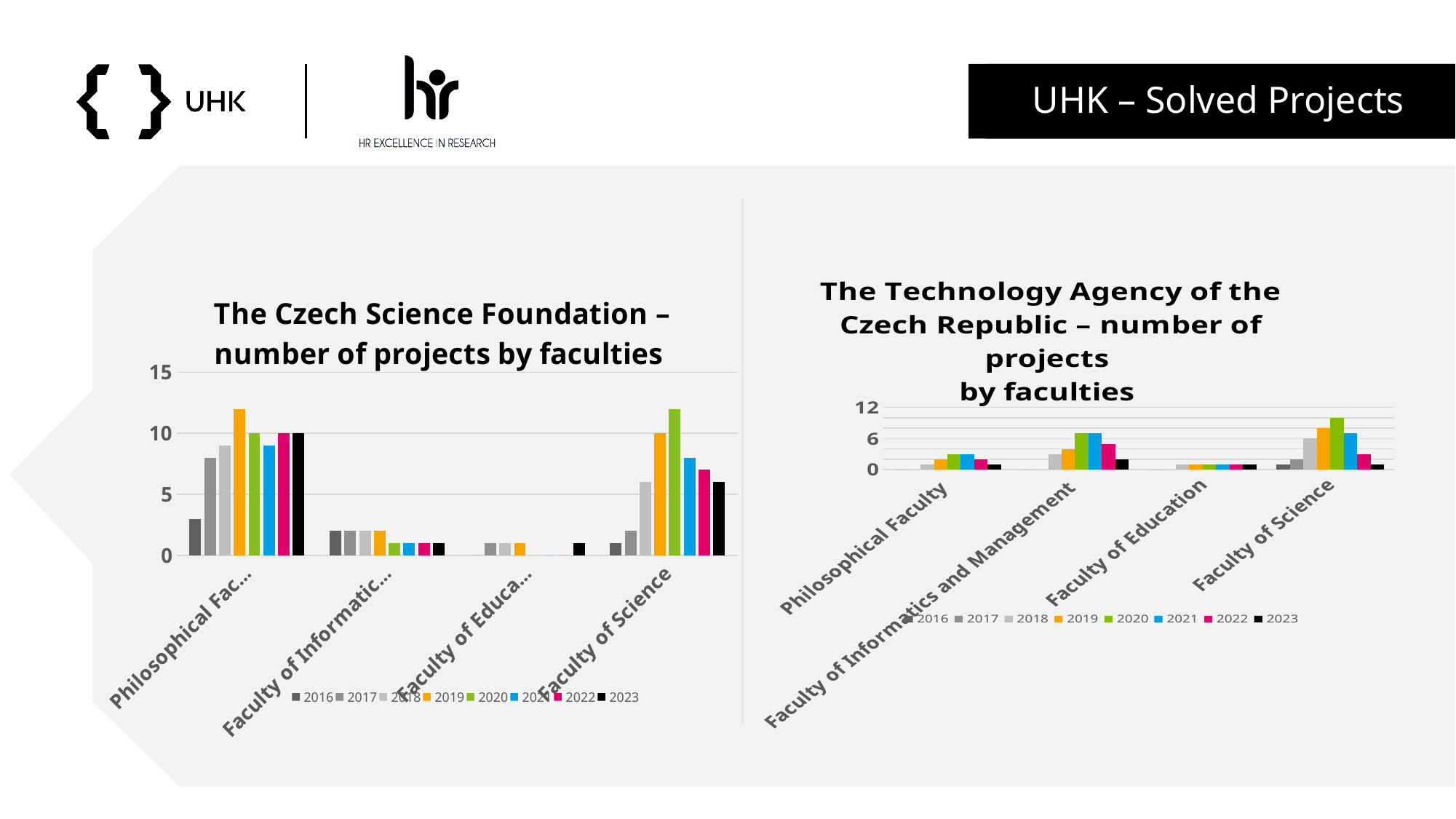
In 'The Technology Agency of the Czech Republic – number of projects by faculties' chart, is the 2020 value for Faculty of Science greater or less than 6? greater In 'The Czech Science Foundation – number of projects by faculties' chart, is the 2019 value for Philosophical Faculty greater or less than 10? greater What kind of chart is 'The Czech Science Foundation – number of projects by faculties'? bar chart In 'The Technology Agency of the Czech Republic – number of projects by faculties' chart, which faculty has the lowest bars overall? Faculty of Education In 'The Czech Science Foundation – number of projects by faculties' chart, which is larger: the 2017 value for Philosophical Faculty or the 2017 value for Faculty of Science? Philosophical Faculty In 'The Czech Science Foundation – number of projects by faculties' chart, how many faculties are shown on the x axis? 4 In 'The Technology Agency of the Czech Republic – number of projects by faculties' chart, which faculty has the tallest bar for 2020? Faculty of Science In 'The Czech Science Foundation – number of projects by faculties' chart, is the 2018 value for Faculty of Science greater or less than 5? greater In 'The Technology Agency of the Czech Republic – number of projects by faculties' chart, how many series does the legend list? 8 In 'The Czech Science Foundation – number of projects by faculties' chart, what is the 2023 value for Philosophical Faculty? 10 In 'The Czech Science Foundation – number of projects by faculties' chart, how many series does the legend list? 8 In 'The Czech Science Foundation – number of projects by faculties' chart, which year has the tallest bar for Faculty of Science? 2020